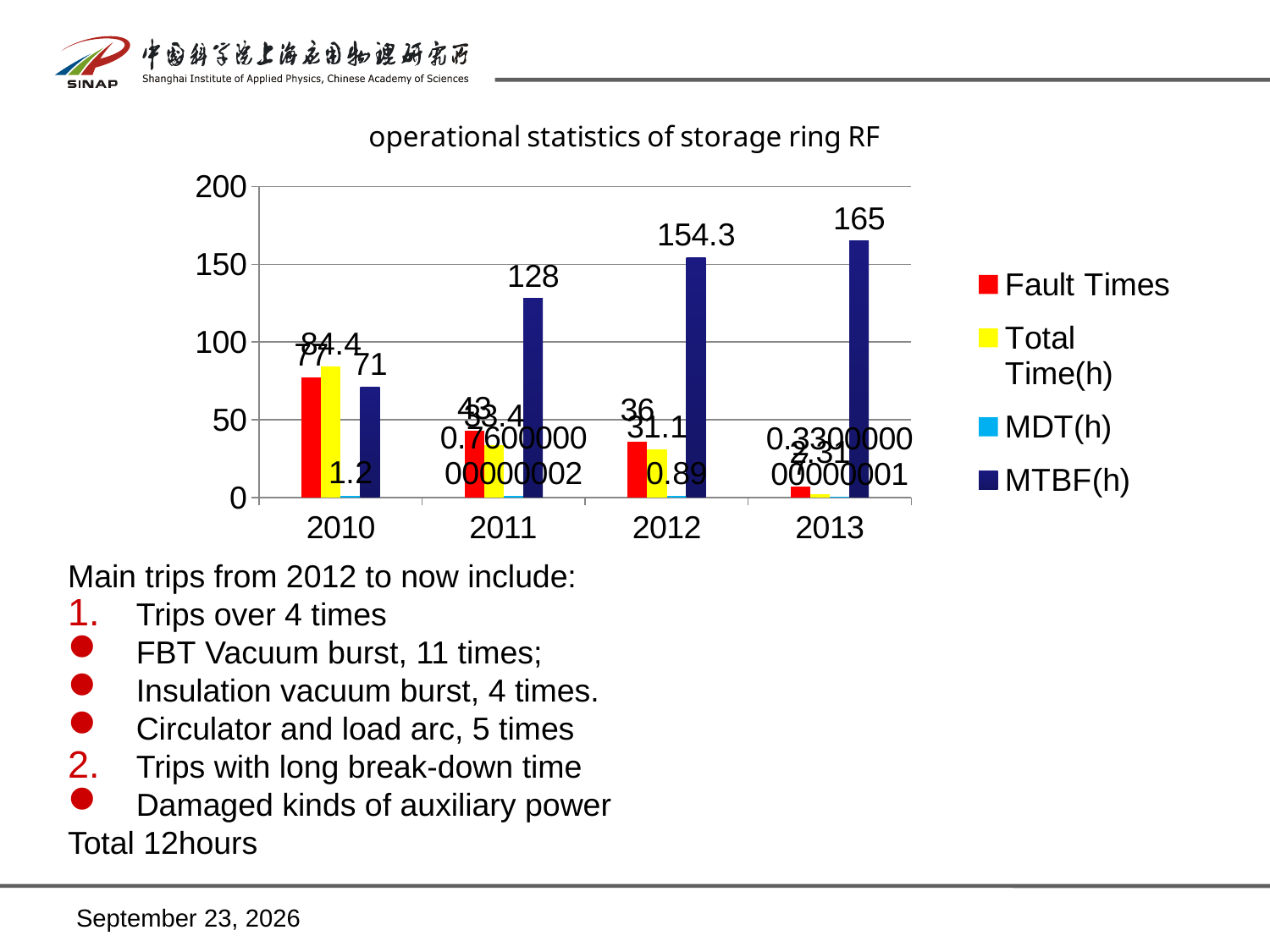
What is the Fault Times value for 2010? 77 How many series does the legend list? 4 What is the MTBF(h) value for 2013? 165 Which year has the lowest MTBF(h)? 2010 Which year has the highest MTBF(h)? 2013 Does the MTBF(h) value rise or fall from 2010 to 2013? rise What is the MTBF(h) value for 2012? 154.3 What is the difference between the MTBF(h) values for 2013 and 2012? 10.7 What is the MDT(h) value for 2012? 0.89 Which year has the larger Fault Times value, 2010 or 2012? 2010 What is the title of the chart? operational statistics of storage ring RF How many years are shown on the x axis? 4